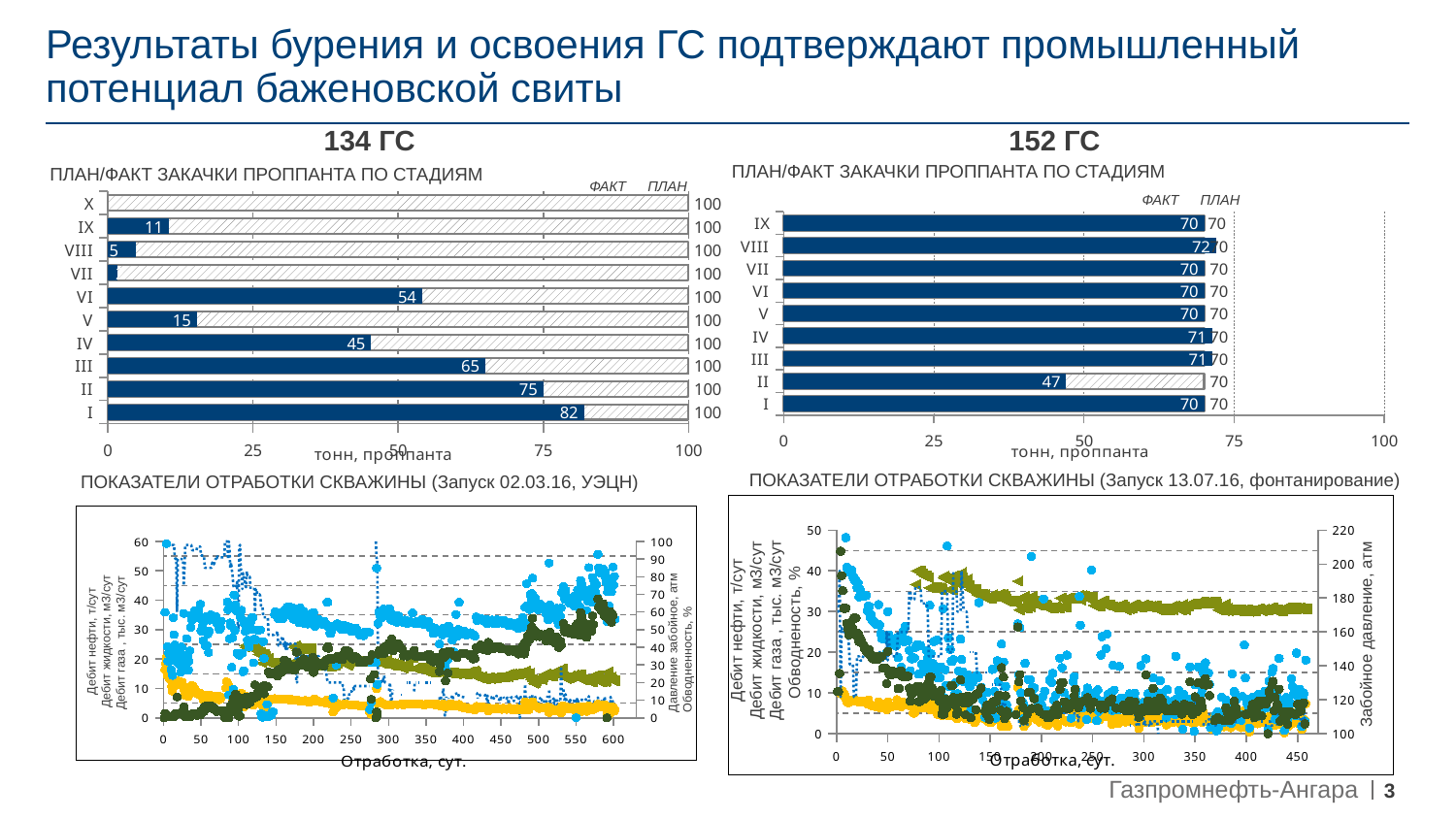
What kind of chart is the 134 ГС ПЛАН/ФАКТ ЗАКАЧКИ ПРОППАНТА ПО СТАДИЯМ chart? bar chart On the 134 ГС chart, what is the ФАКТ value for stage III? 65 On the 134 ГС chart, which stage has the larger ФАКТ value, VI or V? VI On the 134 ГС chart, which stage has the highest ФАКТ value? I On the 134 ГС chart, what is the ПЛАН value for stage II? 100 On the 152 ГС chart (ПЛАН/ФАКТ ЗАКАЧКИ ПРОППАНТА ПО СТАДИЯМ), what is the ФАКТ value for stage II? 47 On the 134 ГС chart, what is the difference between the ФАКТ values for stage II and stage IV? 30 On the 152 ГС chart, which stage has the lowest ФАКТ value? II On the 134 ГС chart, how many stages are shown on the vertical axis? 10 On the 152 ГС chart, by how much does the ПЛАН value for stage II exceed the ФАКТ value? 23 On the 152 ГС chart, how many stages are shown on the vertical axis? 9 On the 134 ГС chart (ПЛАН/ФАКТ ЗАКАЧКИ ПРОППАНТА ПО СТАДИЯМ), what is the ФАКТ value for stage I? 82